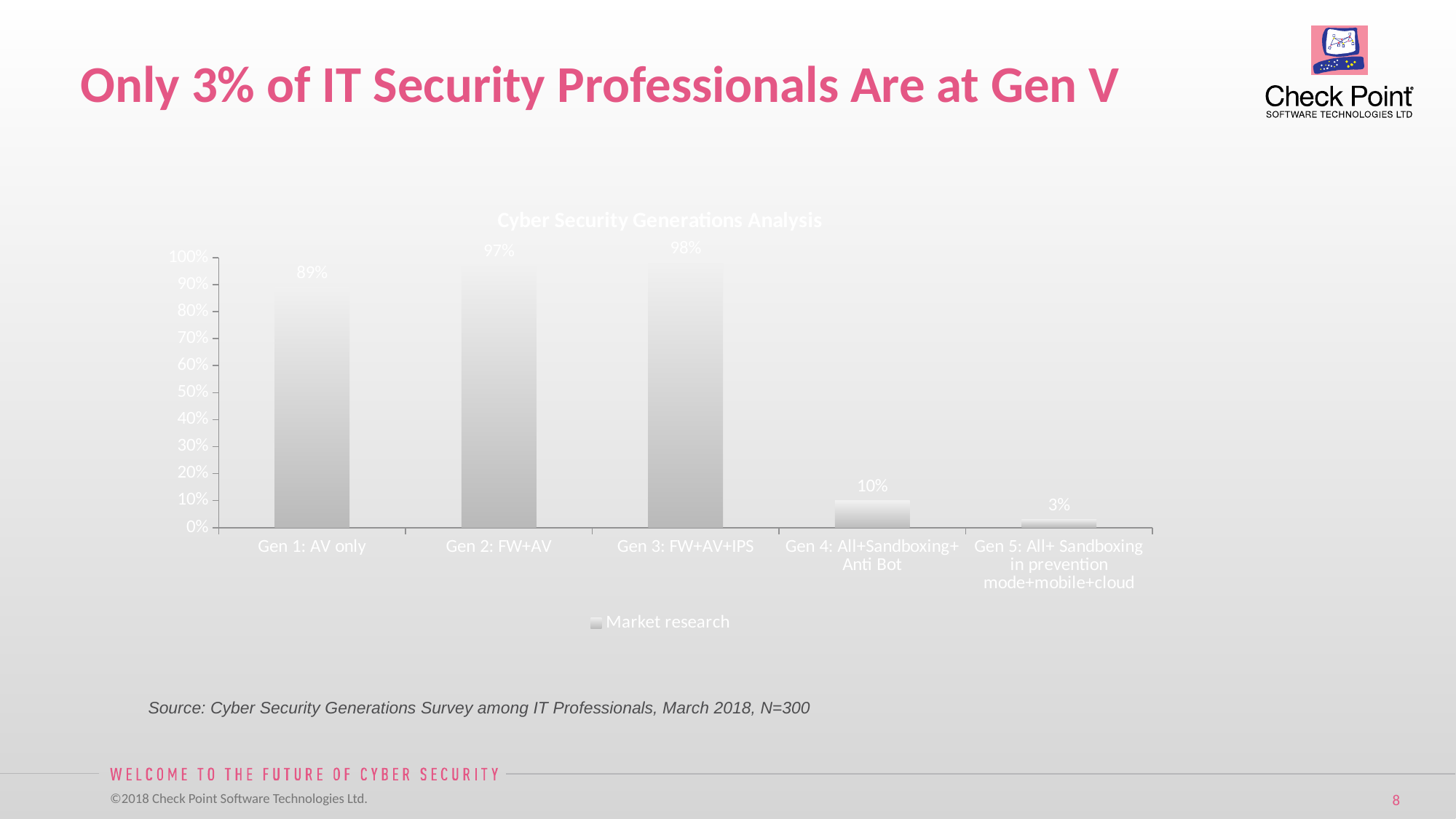
What is the value for Gen 2: FW+AV? 97% What is the value for Gen 3: FW+AV+IPS? 98% What is the difference between the values for Gen 3: FW+AV+IPS and Gen 4: All+Sandboxing+Anti Bot? 88% What is the value for Gen 1: AV only? 89% How many series does the legend list? 1 What is the value for Gen 4: All+Sandboxing+Anti Bot? 10% Which is larger, the value for Gen 1: AV only or the value for Gen 2: FW+AV? Gen 2: FW+AV What is the value for Gen 5: All+ Sandboxing in prevention mode+mobile+cloud? 3% Which category has the lowest value? Gen 5: All+ Sandboxing in prevention mode+mobile+cloud How many categories are shown on the x axis? 5 What is the title of the chart? Cyber Security Generations Analysis What kind of chart is shown on the slide? bar chart